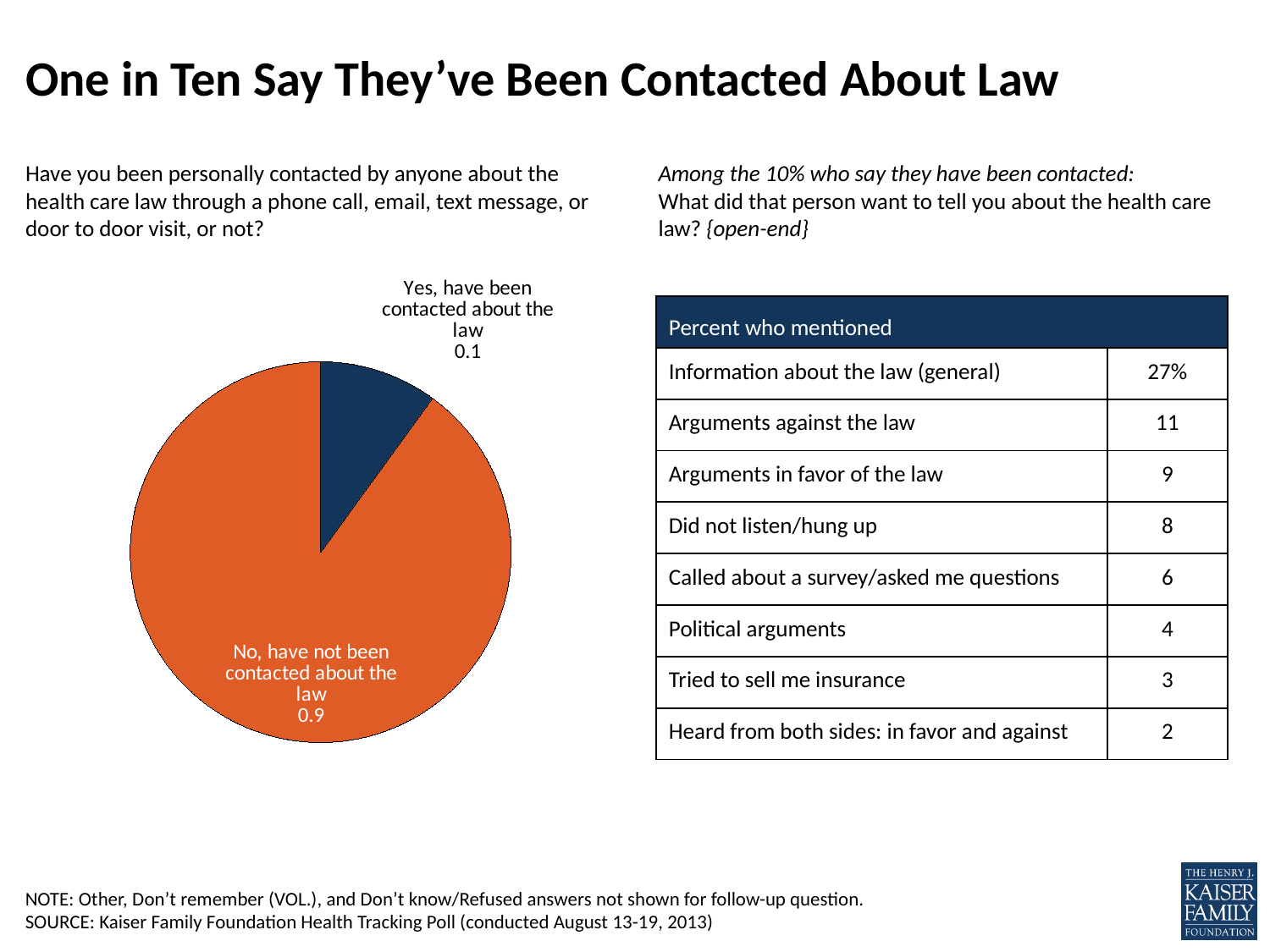
What colour is the "Yes, have been contacted about the law" slice in the pie chart? dark blue Which slice of the pie chart is the largest? No, have not been contacted about the law Which is larger in the pie chart: the "Yes, have been contacted" slice or the "No, have not been contacted" slice? No, have not been contacted about the law What kind of chart is shown on the slide? pie chart How many slices does the pie chart have? 2 What colour is the "No, have not been contacted about the law" slice in the pie chart? orange What is the difference between the "No" slice and the "Yes" slice in the pie chart? 0.8 Which slice of the pie chart is the smallest? Yes, have been contacted about the law In the pie chart, what is the value for "Yes, have been contacted about the law"? 0.1 In the pie chart, what is the value for "No, have not been contacted about the law"? 0.9